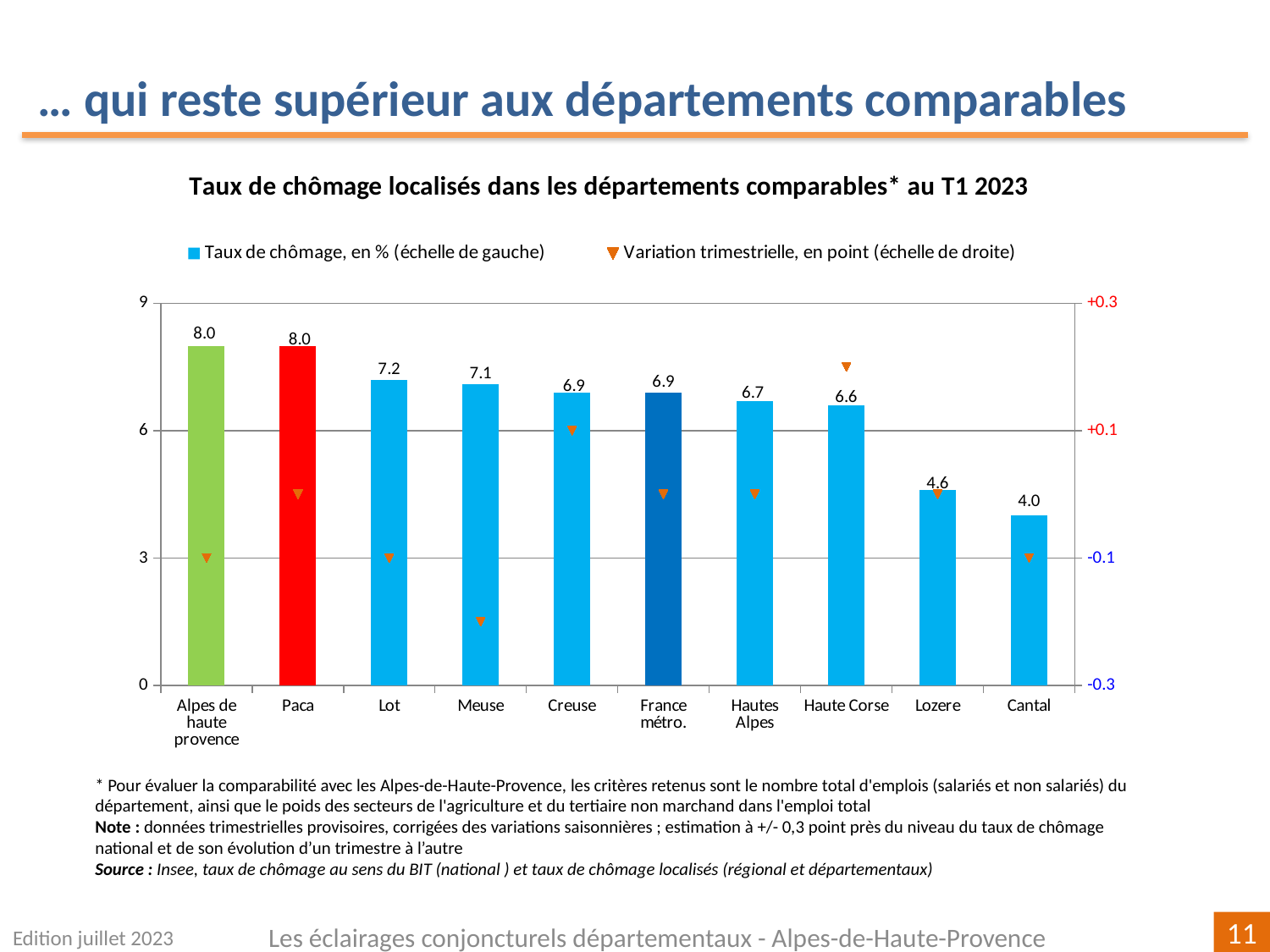
What is the unemployment rate shown for Haute Corse? 6.6 What kind of chart is used to show the unemployment rates? bar chart What is the difference between the unemployment rates of Lot and Cantal? 3.2 How many categories (departments/areas) are shown on the x axis? 10 Which category has the lowest unemployment rate? Cantal Is the quarterly variation (right axis) for Haute Corse greater or less than +0.1? greater Which has a higher unemployment rate, Meuse or Hautes Alpes? Meuse What is the unemployment rate shown for France métro.? 6.9 What is the unemployment rate shown for Lot? 7.2 Is the unemployment rate for Lozere greater or less than 6? less What colour is the bar for Paca? red How many series does the legend list? 2